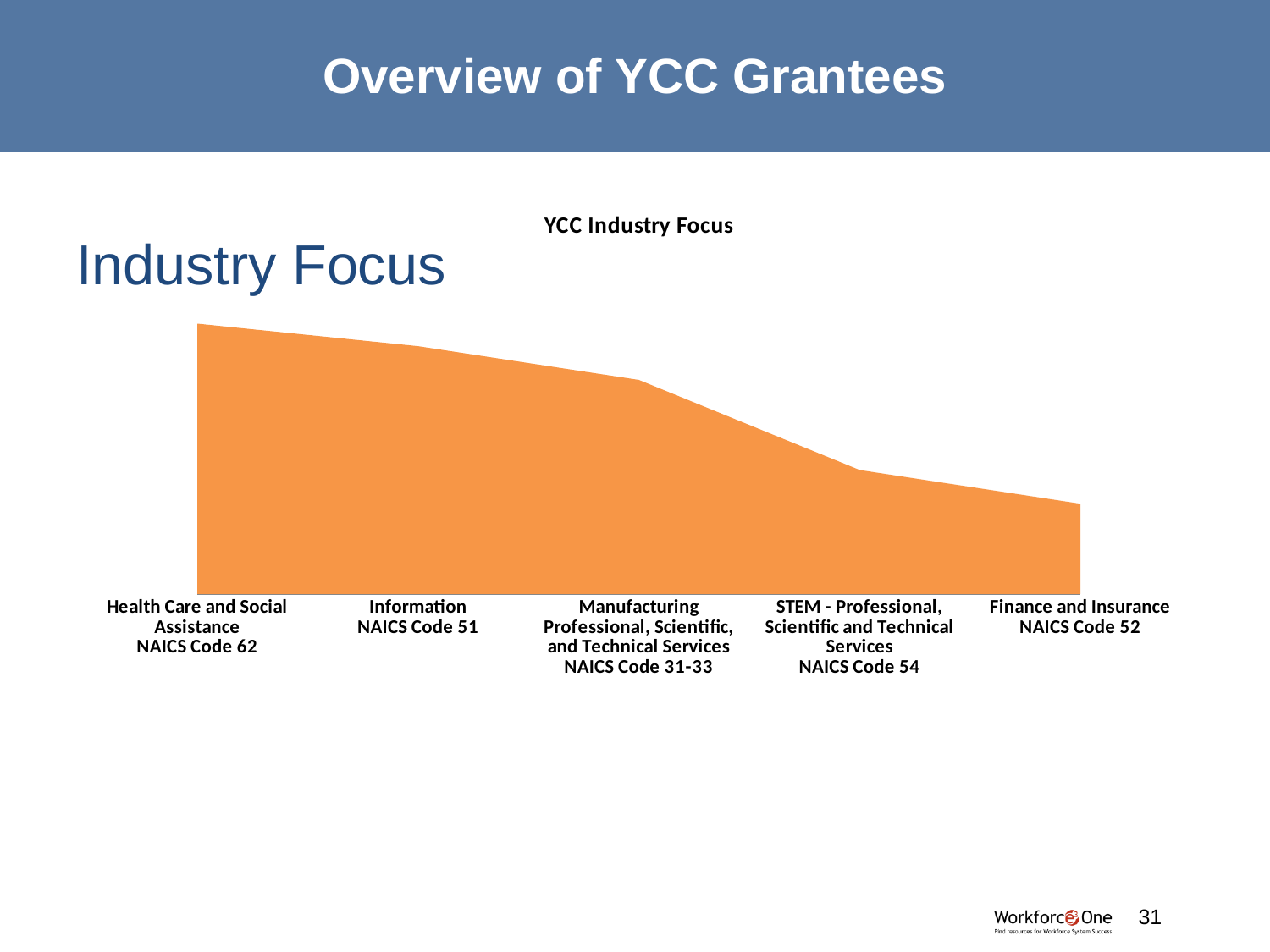
Which has the larger value: Health Care and Social Assistance NAICS Code 62 or STEM - Professional, Scientific and Technical Services NAICS Code 54? Health Care and Social Assistance NAICS Code 62 Which industry category has the highest value in the chart? Health Care and Social Assistance NAICS Code 62 How many industry categories are plotted along the x axis of the chart? 5 Which industry category has the lowest value in the chart? Finance and Insurance NAICS Code 52 What kind of chart is shown on the slide? Area chart Which has the larger value: Information NAICS Code 51 or STEM - Professional, Scientific and Technical Services NAICS Code 54? Information NAICS Code 51 What is the title of the chart? YCC Industry Focus Do the values rise or fall moving from left to right along the x axis? Fall Which has the larger value: Manufacturing NAICS Code 31-33 or Finance and Insurance NAICS Code 52? Manufacturing NAICS Code 31-33 What colour is the plotted area in the chart? Orange Which category is plotted first (leftmost) on the x axis? Health Care and Social Assistance NAICS Code 62